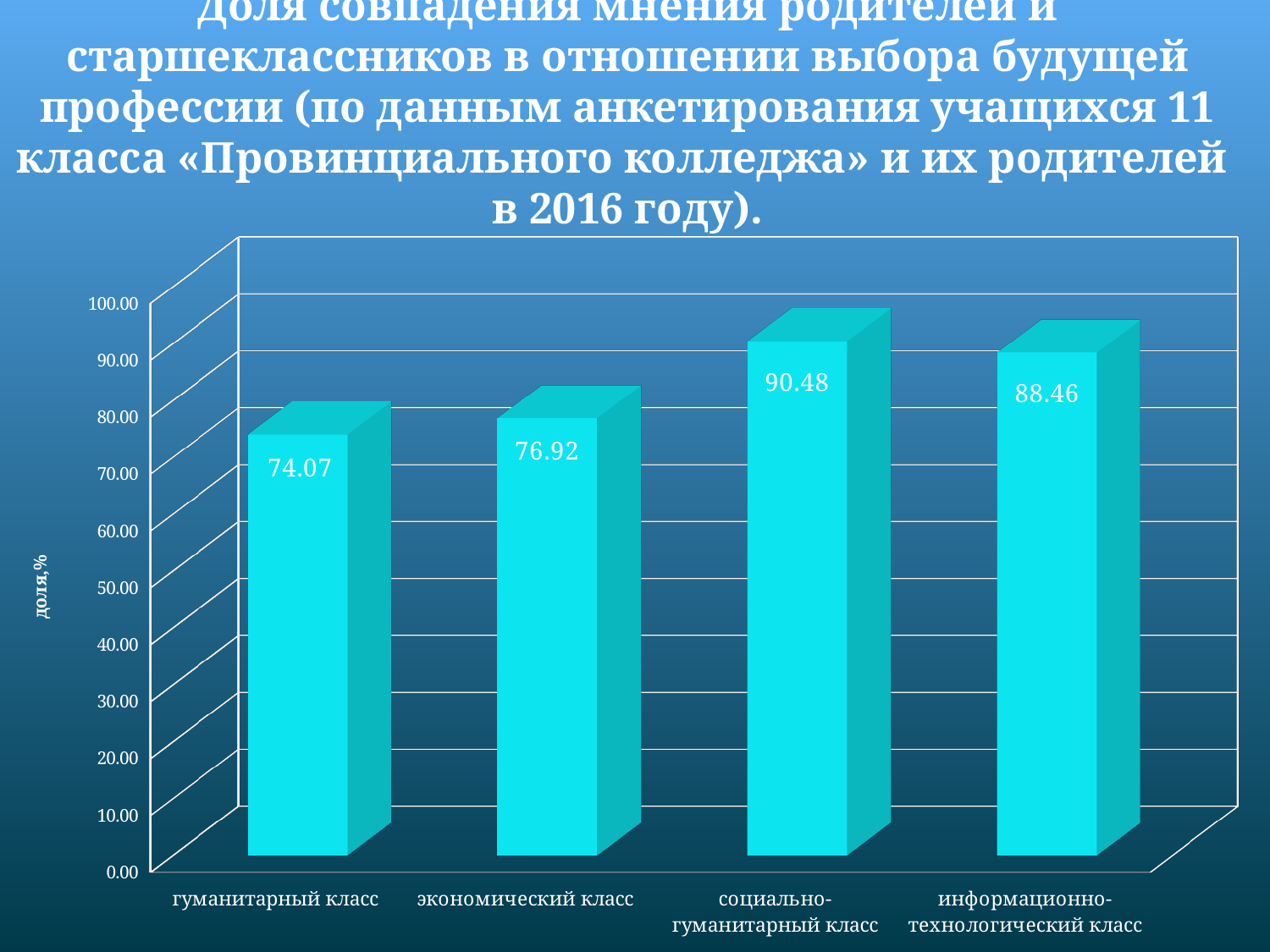
What kind of chart is shown on the slide? bar chart What is the value for экономический класс? 76.92 Which category has the lowest value? гуманитарный класс What is the value for информационно-технологический класс? 88.46 What is the value for гуманитарный класс? 74.07 Which is larger, the value for экономический класс or the value for гуманитарный класс? экономический класс Which category has the highest value? социально-гуманитарный класс What is the value for социально-гуманитарный класс? 90.48 Is the value for гуманитарный класс greater or less than 80.00? less What is the difference between the values for социально-гуманитарный класс and гуманитарный класс? 16.41 What is the difference between the values for информационно-технологический класс and экономический класс? 11.54 How many categories are shown on the chart? 4